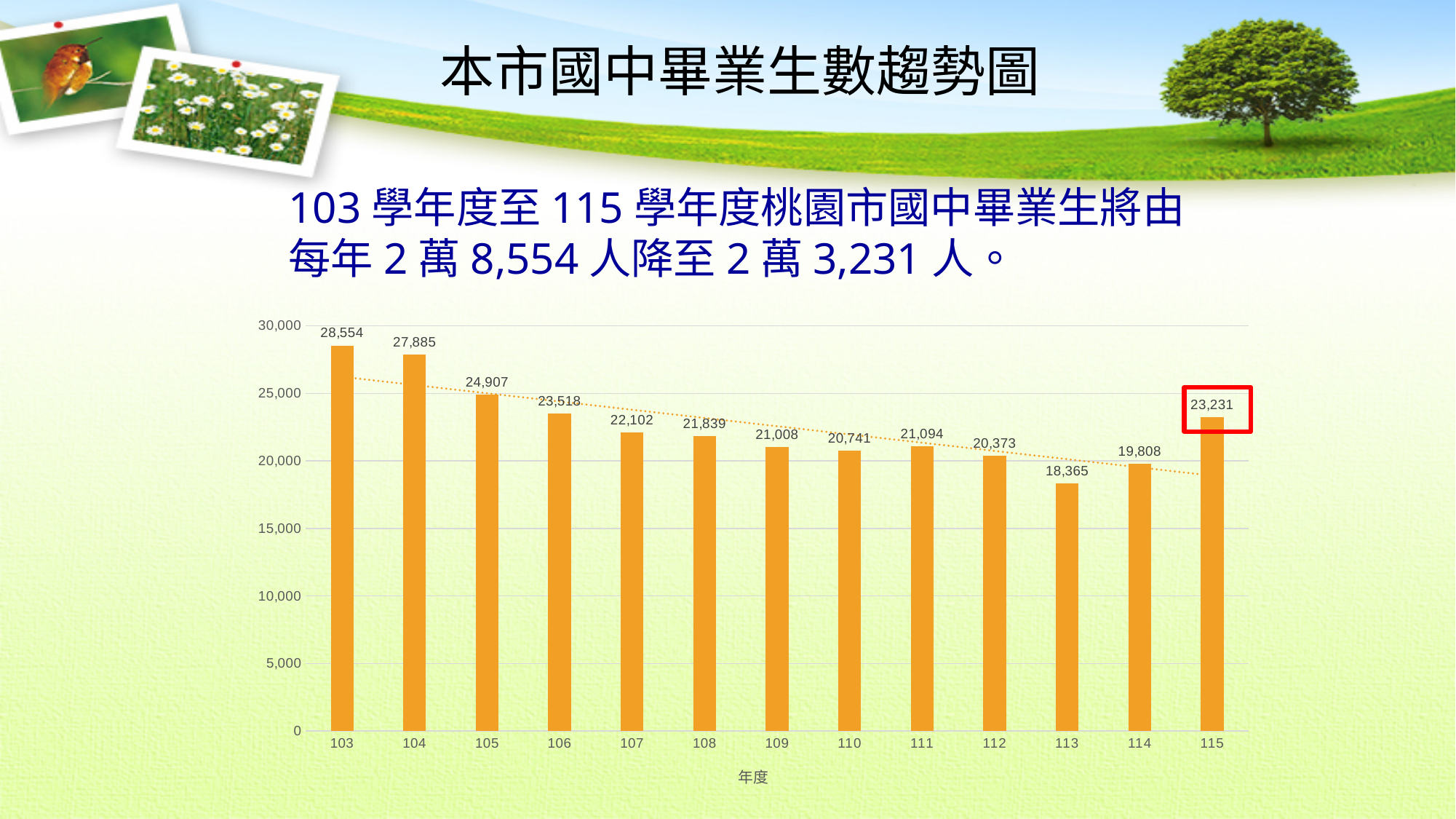
What is the x-axis title of the chart? 年度 Is the value for year 114 greater or less than 20,000? less What is the difference between the values for year 103 and year 115? 5,323 Do the values generally rise or fall from year 103 to year 113? fall What is the value for year 113? 18,365 What kind of chart is this? bar chart What is the value for year 115? 23,231 What is the value for year 103? 28,554 Which year has the lowest value? 113 How many years are shown on the x axis? 13 Which year has the highest value? 103 Which is larger, the value for year 111 or the value for year 110? 111